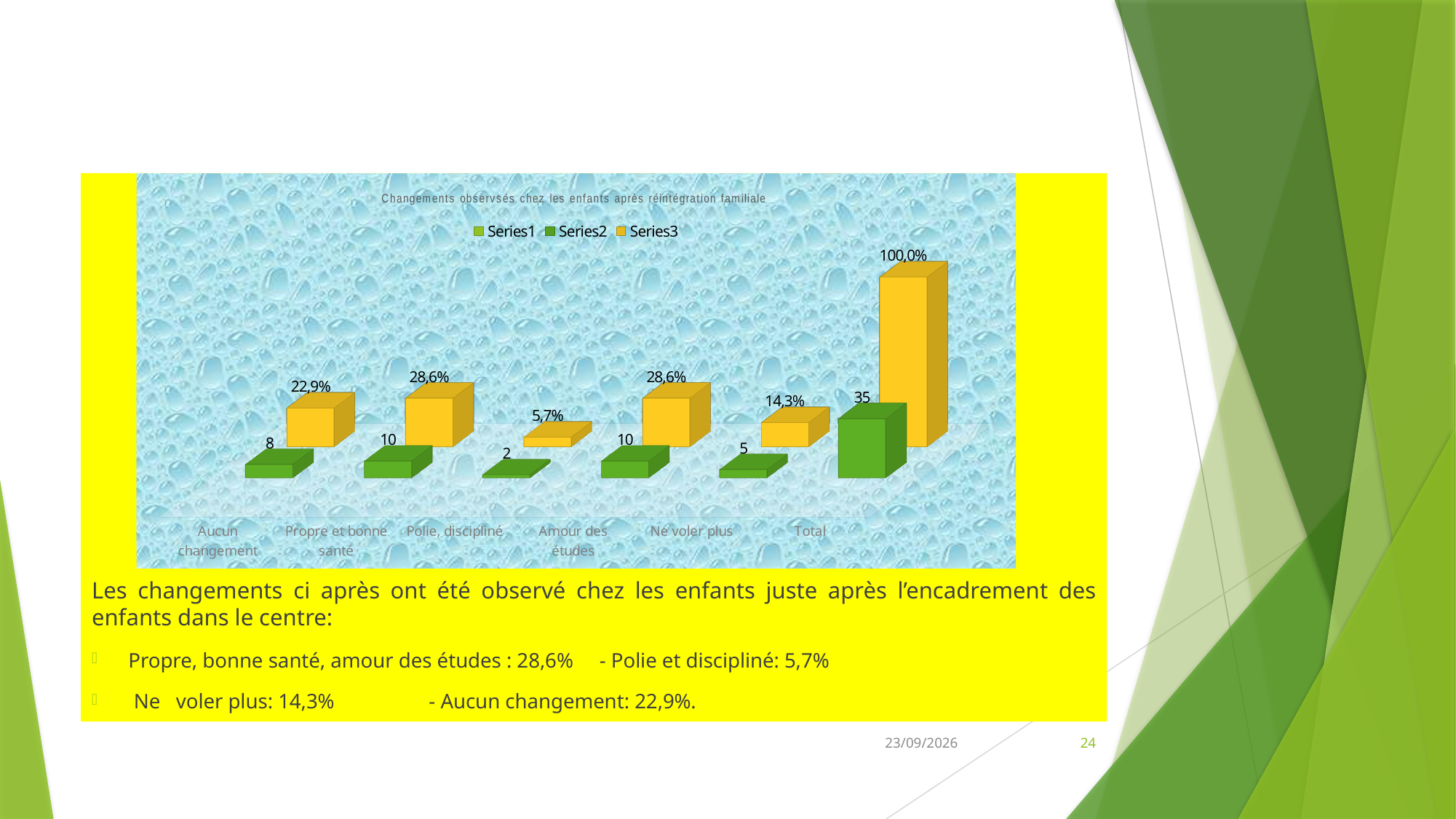
What is the count value (green bar) for 'Ne voler plus'? 5 What is the difference between the percentage values for 'Amour des études' and 'Ne voler plus'? 14,3% How many categories are shown on the x axis of the chart? 6 What is the title of the chart? Changements observsés chez les enfants après réintégration familiale How many series does the chart legend list? 3 What is the difference between the green bar values for 'Propre et bonne santé' and 'Polie, discipliné'? 8 What is the percentage value (yellow bar) for 'Aucun changement'? 22,9% Which is larger, the percentage for 'Aucun changement' or the percentage for 'Ne voler plus'? Aucun changement What is the percentage value (yellow bar) for 'Polie, discipliné'? 5,7% Excluding 'Total', which category has the lowest percentage value? Polie, discipliné What is the count value (green bar) for 'Total'? 35 What type of chart is shown on the slide? bar chart